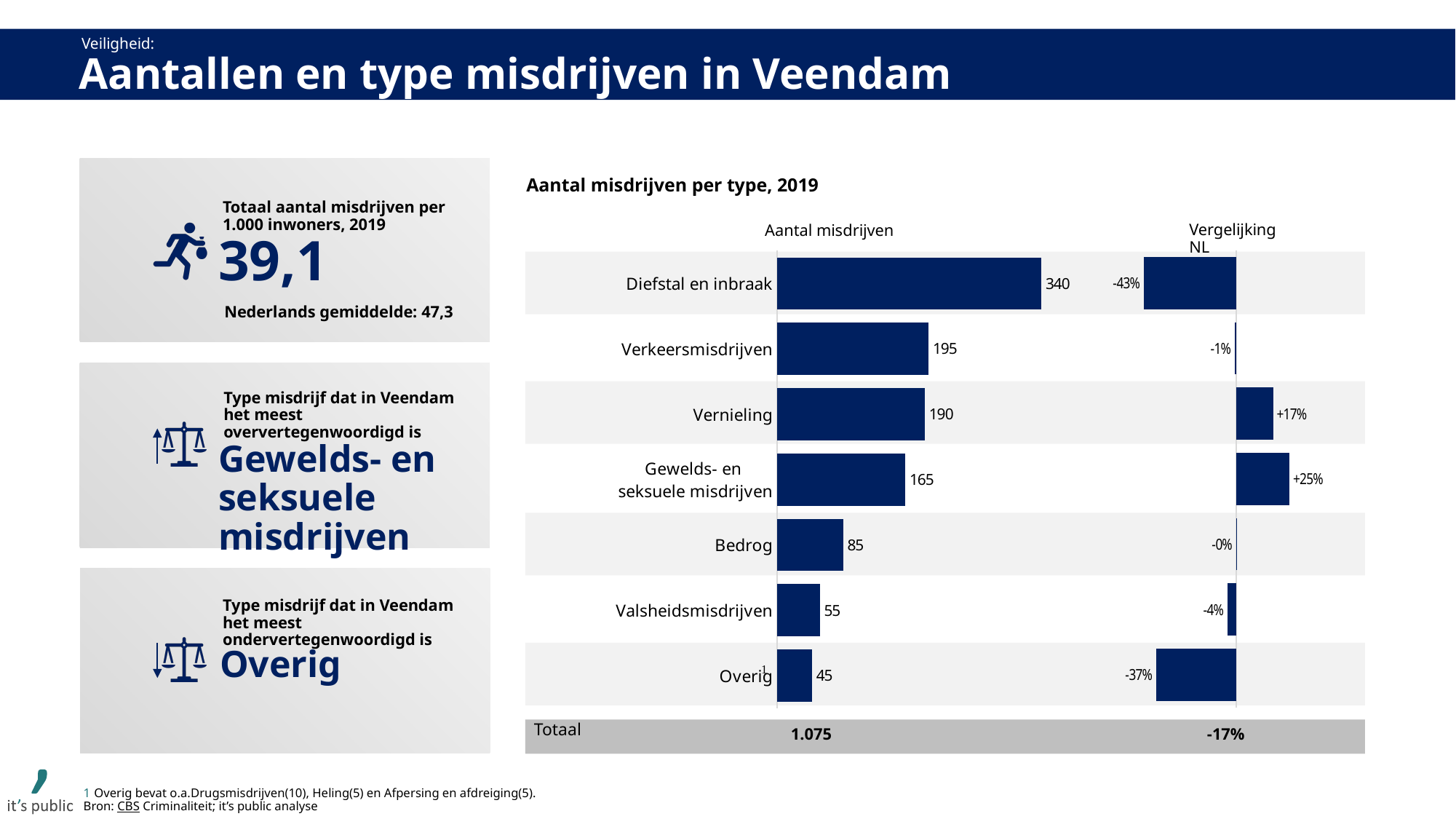
In the chart 'Aantal misdrijven per type, 2019', how many crime types are listed (excluding the Totaal row)? 7 In the chart 'Aantal misdrijven per type, 2019', which crime type has the lowest Aantal misdrijven? Overig In the chart 'Aantal misdrijven per type, 2019', what is the number of crimes (Aantal misdrijven) for Diefstal en inbraak? 340 In the chart 'Aantal misdrijven per type, 2019', what is the Totaal value for Vergelijking NL? -17% In the chart 'Aantal misdrijven per type, 2019', what is the Totaal value for Aantal misdrijven? 1.075 In the chart 'Aantal misdrijven per type, 2019', what is the Vergelijking NL value for Gewelds- en seksuele misdrijven? +25% In the chart 'Aantal misdrijven per type, 2019', what is the difference in Aantal misdrijven between Diefstal en inbraak and Verkeersmisdrijven? 145 In the chart 'Aantal misdrijven per type, 2019', which crime type has the lowest Vergelijking NL value? Diefstal en inbraak In the chart 'Aantal misdrijven per type, 2019', which has a larger Aantal misdrijven: Vernieling or Gewelds- en seksuele misdrijven? Vernieling What kind of chart is 'Aantal misdrijven per type, 2019'? Bar chart In the chart 'Aantal misdrijven per type, 2019', what is the Aantal misdrijven value for Bedrog? 85 In the chart 'Aantal misdrijven per type, 2019', which crime type has the highest Aantal misdrijven? Diefstal en inbraak